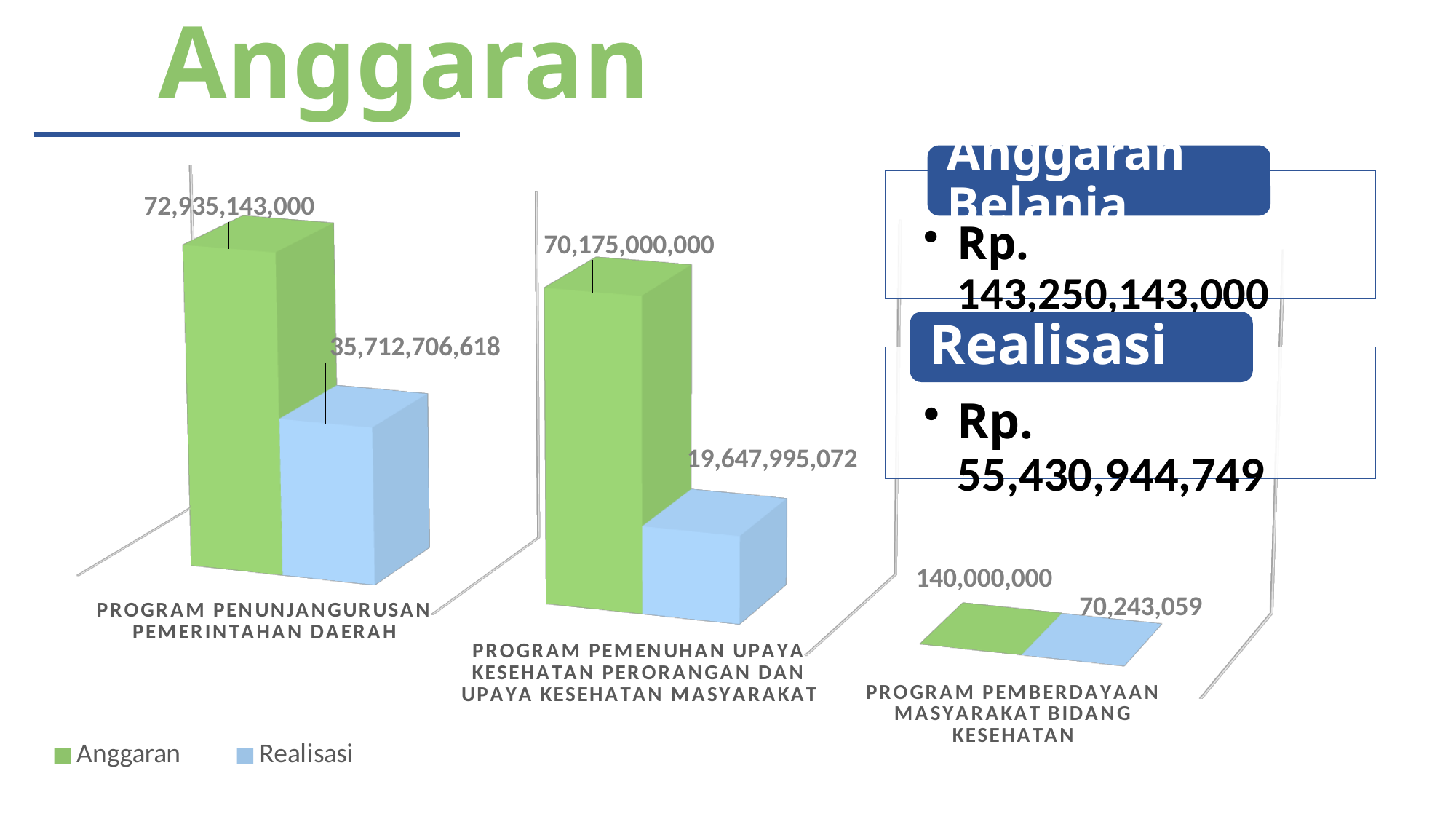
Which program has the highest Anggaran value? PROGRAM PENUNJANGURUSAN PEMERINTAHAN DAERAH What is the Anggaran value for PROGRAM PEMBERDAYAAN MASYARAKAT BIDANG KESEHATAN? 140,000,000 What is the Realisasi value for PROGRAM PEMENUHAN UPAYA KESEHATAN PERORANGAN DAN UPAYA KESEHATAN MASYARAKAT? 19,647,995,072 Which is larger: the Anggaran for PROGRAM PENUNJANGURUSAN PEMERINTAHAN DAERAH or the Anggaran for PROGRAM PEMENUHAN UPAYA KESEHATAN PERORANGAN DAN UPAYA KESEHATAN MASYARAKAT? PROGRAM PENUNJANGURUSAN PEMERINTAHAN DAERAH What is the difference between Anggaran and Realisasi for PROGRAM PENUNJANGURUSAN PEMERINTAHAN DAERAH? 37,222,436,382 What is the Anggaran value for PROGRAM PENUNJANGURUSAN PEMERINTAHAN DAERAH? 72,935,143,000 What is the difference between Anggaran and Realisasi for PROGRAM PEMBERDAYAAN MASYARAKAT BIDANG KESEHATAN? 69,756,941 What type of chart is shown on the slide? Bar chart How many programs (categories) are shown in the chart? 3 What is the Realisasi value for PROGRAM PEMBERDAYAAN MASYARAKAT BIDANG KESEHATAN? 70,243,059 How many series does the legend list? 2 Which program has the lowest Realisasi value? PROGRAM PEMBERDAYAAN MASYARAKAT BIDANG KESEHATAN